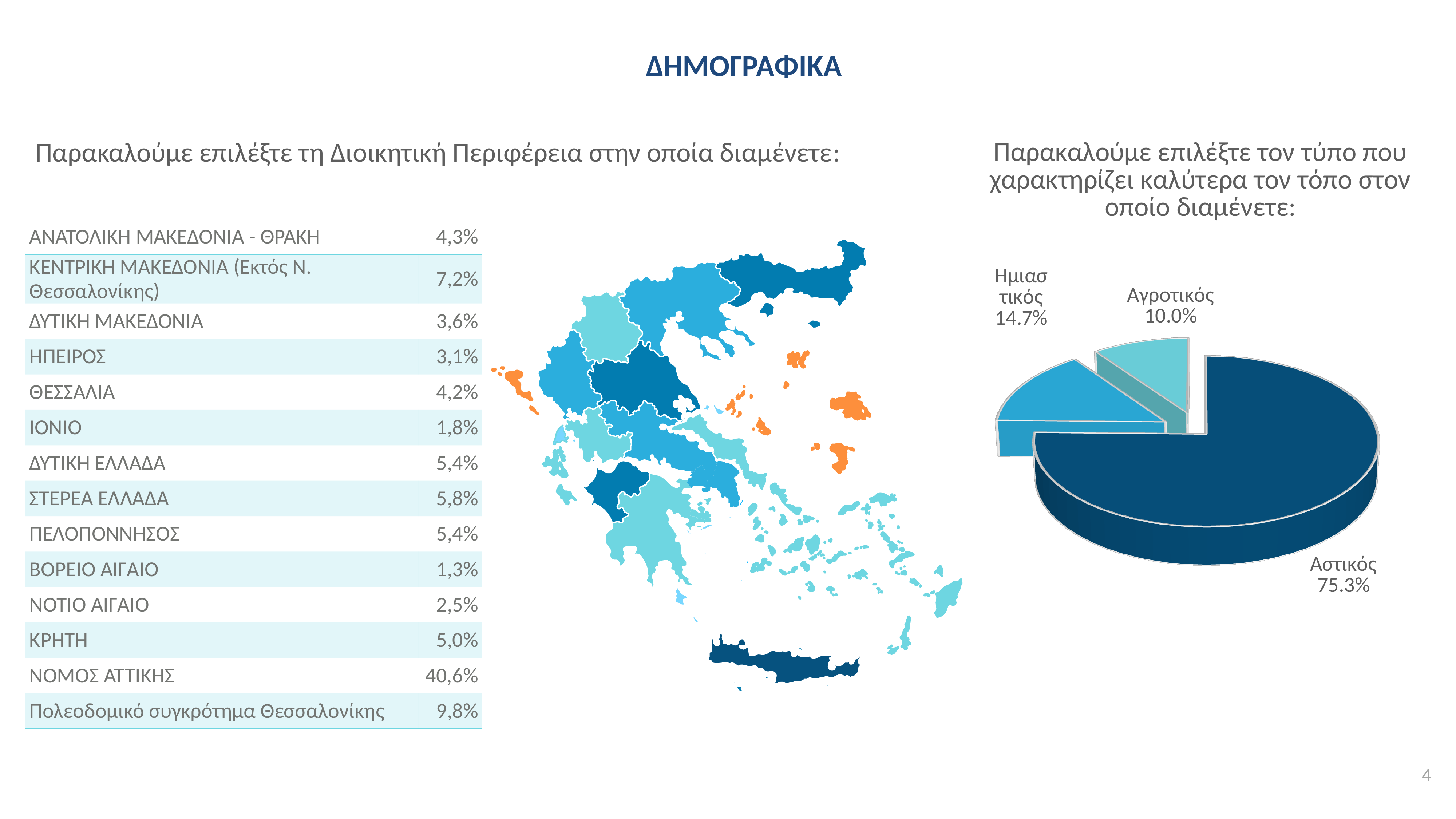
What is the title of the slide? ΔΗΜΟΓΡΑΦΙΚΑ In the pie chart on the right, what is the difference in percentage points between Αστικός and Ημιαστικός? 60.6 In the pie chart on the right, which category has the largest slice? Αστικός In the pie chart on the right, what is the combined share of Ημιαστικός and Αγροτικός? 24.7% In the pie chart on the right, which category has the smallest slice? Αγροτικός In the pie chart on the right, what is the difference in percentage points between Ημιαστικός and Αγροτικός? 4.7 In the pie chart on the right, what share is labelled for Αγροτικός? 10.0% In the pie chart on the right, what share is labelled for Ημιαστικός? 14.7% In the pie chart on the right, what share is labelled for Αστικός? 75.3% In the pie chart on the right, which is larger, Ημιαστικός or Αγροτικός? Ημιαστικός How many slices does the pie chart on the right have? 3 What kind of chart is shown on the right side of the slide? Pie chart